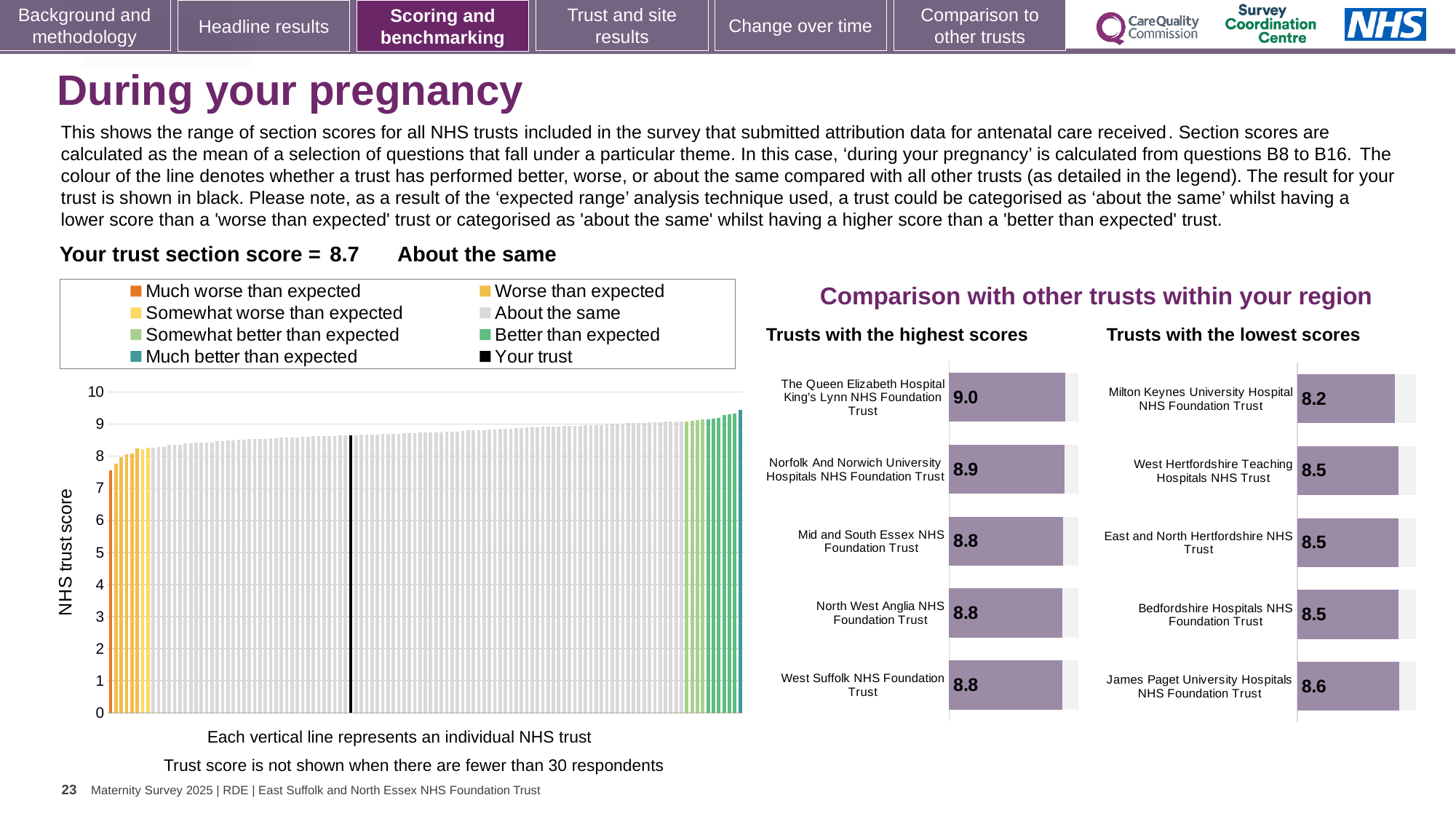
In the 'Trusts with the highest scores' chart, which has the higher score: Norfolk And Norwich University Hospitals NHS Foundation Trust or Mid and South Essex NHS Foundation Trust? Norfolk And Norwich University Hospitals NHS Foundation Trust In the 'Trusts with the highest scores' chart, what is the score for The Queen Elizabeth Hospital King's Lynn NHS Foundation Trust? 9.0 How many entries does the legend of the 'NHS trust score' chart on the left list? 8 In the 'NHS trust score' chart on the left, do the trust scores rise or fall from left to right? rise In the 'Trusts with the highest scores' chart, what is the score for Norfolk And Norwich University Hospitals NHS Foundation Trust? 8.9 In the 'Trusts with the lowest scores' chart, what is the difference between the scores of James Paget University Hospitals NHS Foundation Trust and Milton Keynes University Hospital NHS Foundation Trust? 0.4 What kind of chart is the 'NHS trust score' chart on the left of the slide? bar chart In the 'Trusts with the highest scores' chart, which trust has the highest score? The Queen Elizabeth Hospital King's Lynn NHS Foundation Trust In the 'Trusts with the lowest scores' chart, which trust has the lowest score? Milton Keynes University Hospital NHS Foundation Trust How many trusts are shown in the 'Trusts with the highest scores' chart? 5 In the 'Trusts with the highest scores' chart, what is the difference between the scores of The Queen Elizabeth Hospital King's Lynn NHS Foundation Trust and West Suffolk NHS Foundation Trust? 0.2 In the 'Trusts with the lowest scores' chart, what is the score for Milton Keynes University Hospital NHS Foundation Trust? 8.2